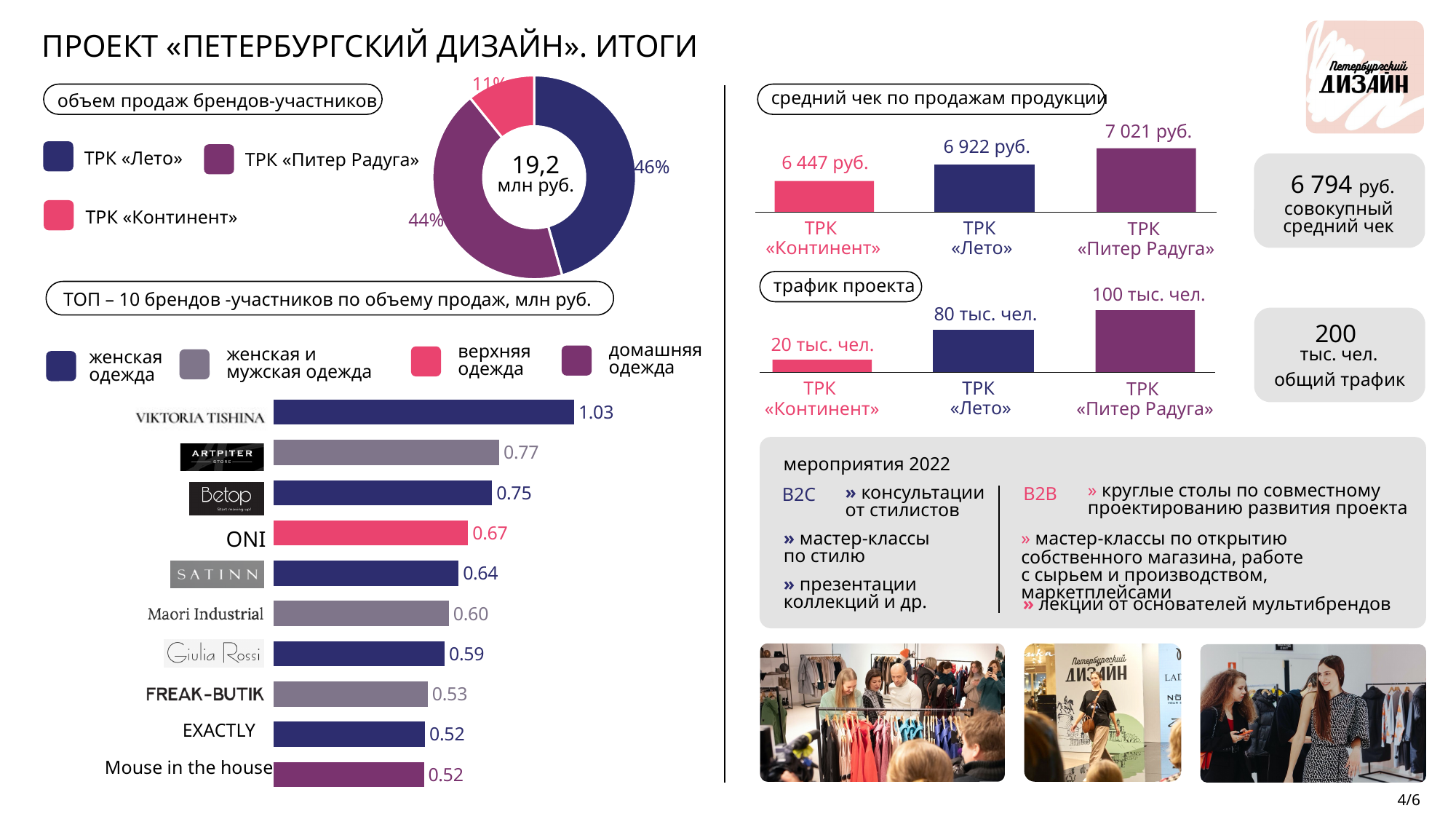
In the chart 'ТОП – 10 брендов-участников по объему продаж', what is the value for Betop? 0.75 What kind of chart is 'ТОП – 10 брендов-участников по объему продаж'? bar chart In the chart 'ТОП – 10 брендов-участников по объему продаж', which brand has the highest sales? VIKTORIA TISHINA In the chart 'средний чек по продажам продукции', what is the value for ТРК «Лето»? 6 922 руб. In the chart 'средний чек по продажам продукции', which shopping centre has the highest average receipt? ТРК «Питер Радуга» In the chart 'ТОП – 10 брендов-участников по объему продаж', what is the difference between VIKTORIA TISHINA and ARTPITER? 0.26 In the chart 'ТОП – 10 брендов-участников по объему продаж', how many brands are shown? 10 In the chart 'трафик проекта', which is larger: ТРК «Лето» or ТРК «Континент»? ТРК «Лето» In the donut chart 'объем продаж брендов-участников', how many categories does the legend list? 3 In the donut chart 'объем продаж брендов-участников', which shopping centre has the smallest share? ТРК «Континент» In the chart 'трафик проекта', what is the difference between ТРК «Питер Радуга» and ТРК «Континент»? 80 тыс. чел. In the donut chart 'объем продаж брендов-участников', what share does ТРК «Лето» have? 46%